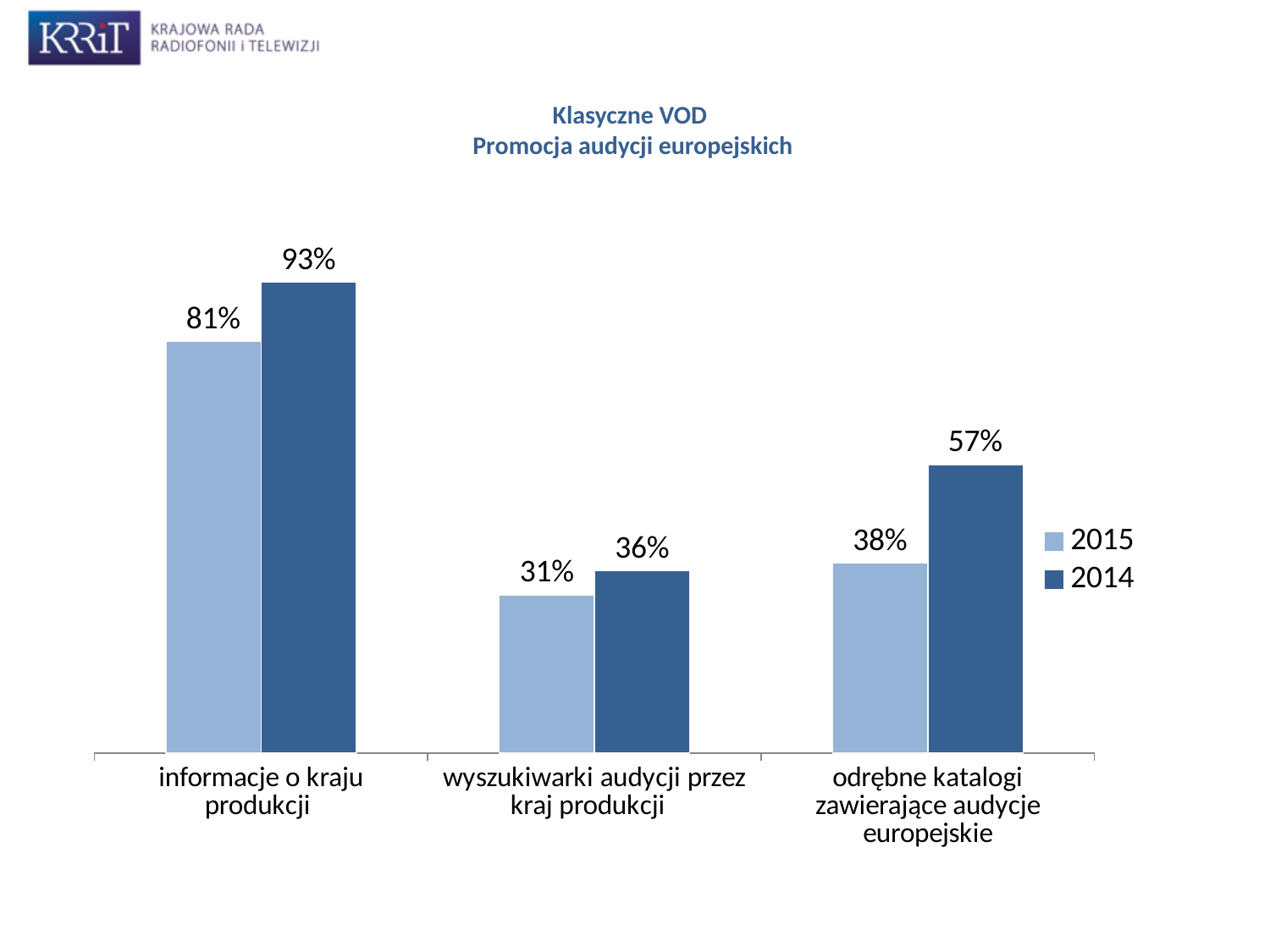
How many series does the legend list? 2 What is the 2014 value for "odrębne katalogi zawierające audycje europejskie"? 57% What is the title of the chart? Klasyczne VOD Promocja audycji europejskich How many categories are shown on the x axis? 3 Which category has the lowest 2015 value? wyszukiwarki audycji przez kraj produkcji What kind of chart is shown on the slide? bar chart What is the 2015 value for "wyszukiwarki audycji przez kraj produkcji"? 31% Which is larger for "wyszukiwarki audycji przez kraj produkcji": the 2015 value or the 2014 value? 2014 What is the 2015 value for "informacje o kraju produkcji"? 81% Which category has the highest 2014 value? informacje o kraju produkcji What is the difference between the 2014 and 2015 values for "informacje o kraju produkcji"? 12% What is the difference between the 2014 and 2015 values for "odrębne katalogi zawierające audycje europejskie"? 19%